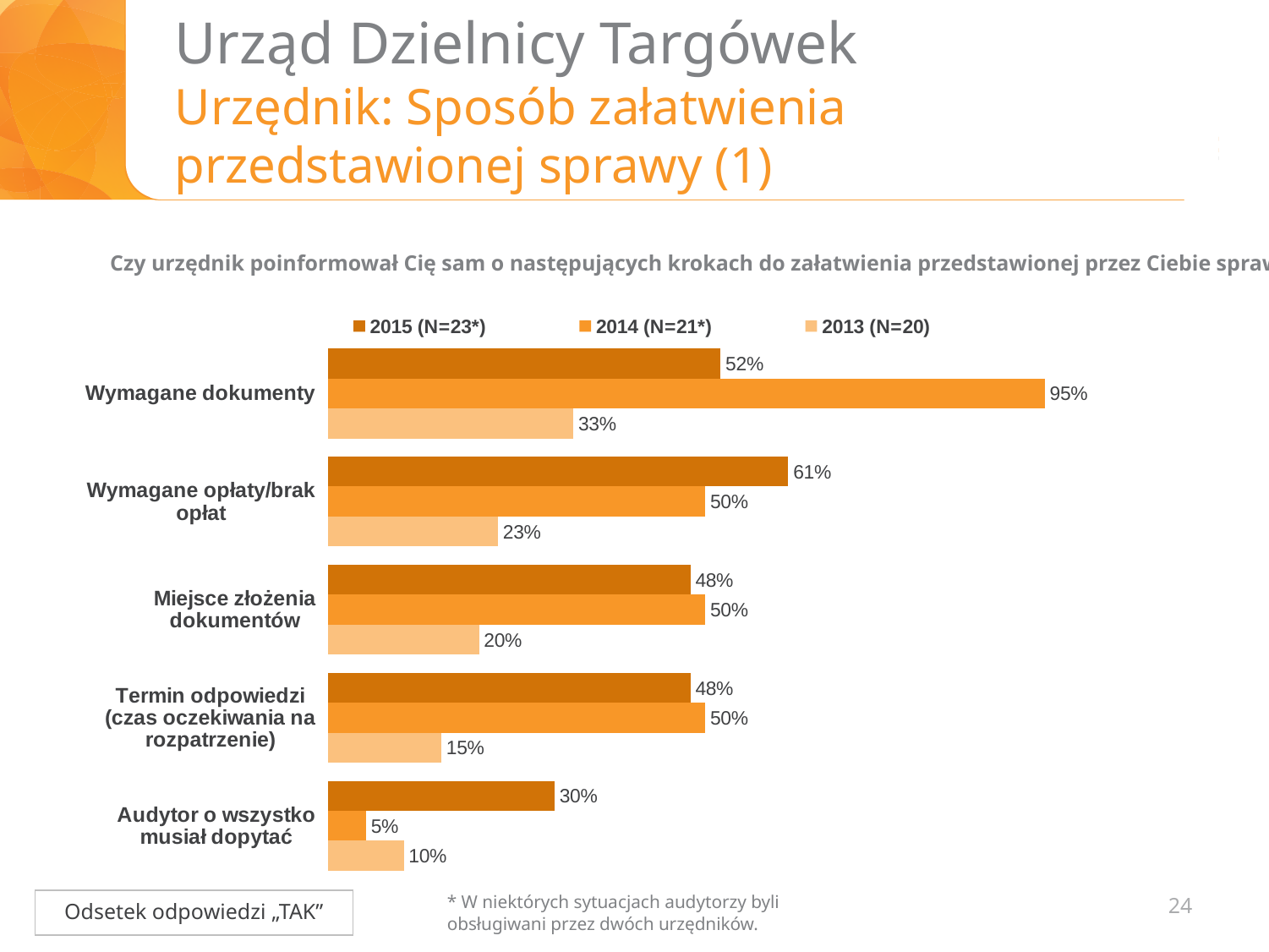
What is the difference between the 2014 (N=21*) and 2015 (N=23*) values for 'Wymagane dokumenty'? 43% Which category has the highest value in the 2015 (N=23*) series? Wymagane opłaty/brak opłat Which category has the lowest value in the 2014 (N=21*) series? Audytor o wszystko musiał dopytać What kind of chart is shown on the slide? Bar chart What is the value for 'Audytor o wszystko musiał dopytać' in the 2015 (N=23*) series? 30% What is the difference between the 2015 (N=23*) and 2013 (N=20) values for 'Wymagane opłaty/brak opłat'? 38% Which series is shown in the lightest orange colour in the legend? 2013 (N=20) What is the value for 'Wymagane dokumenty' in the 2014 (N=21*) series? 95% How many categories are shown on the chart? 5 What is the value for 'Termin odpowiedzi (czas oczekiwania na rozpatrzenie)' in the 2013 (N=20) series? 15% For 'Miejsce złożenia dokumentów', which series has the larger value: 2015 (N=23*) or 2013 (N=20)? 2015 (N=23*) How many series does the legend list? 3